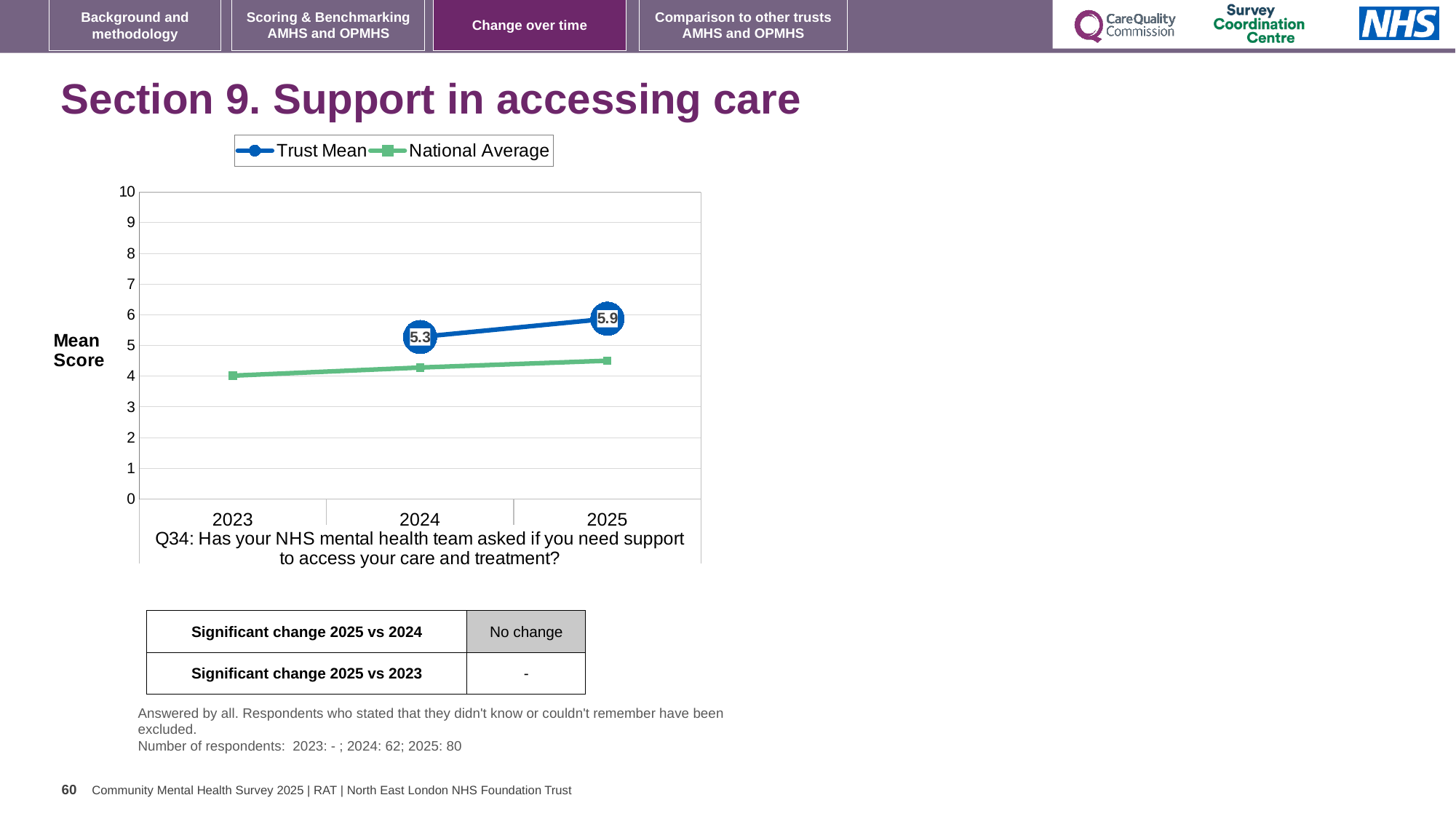
What is the Trust Mean value for 2024? 5.3 Which year has the higher Trust Mean, 2024 or 2025? 2025 Is the National Average value for 2025 greater or less than 4? greater Is the National Average value for 2023 greater or less than 5? less In 2025, which series is higher, Trust Mean or National Average? Trust Mean How many years are shown on the x axis? 3 What is the label on the y axis of the chart? Mean Score What is the Trust Mean value for 2025? 5.9 By how much did the Trust Mean change from 2024 to 2025? 0.6 How many series does the legend list? 2 Does the Trust Mean rise or fall from 2024 to 2025? rise What kind of chart is shown on the slide? line chart